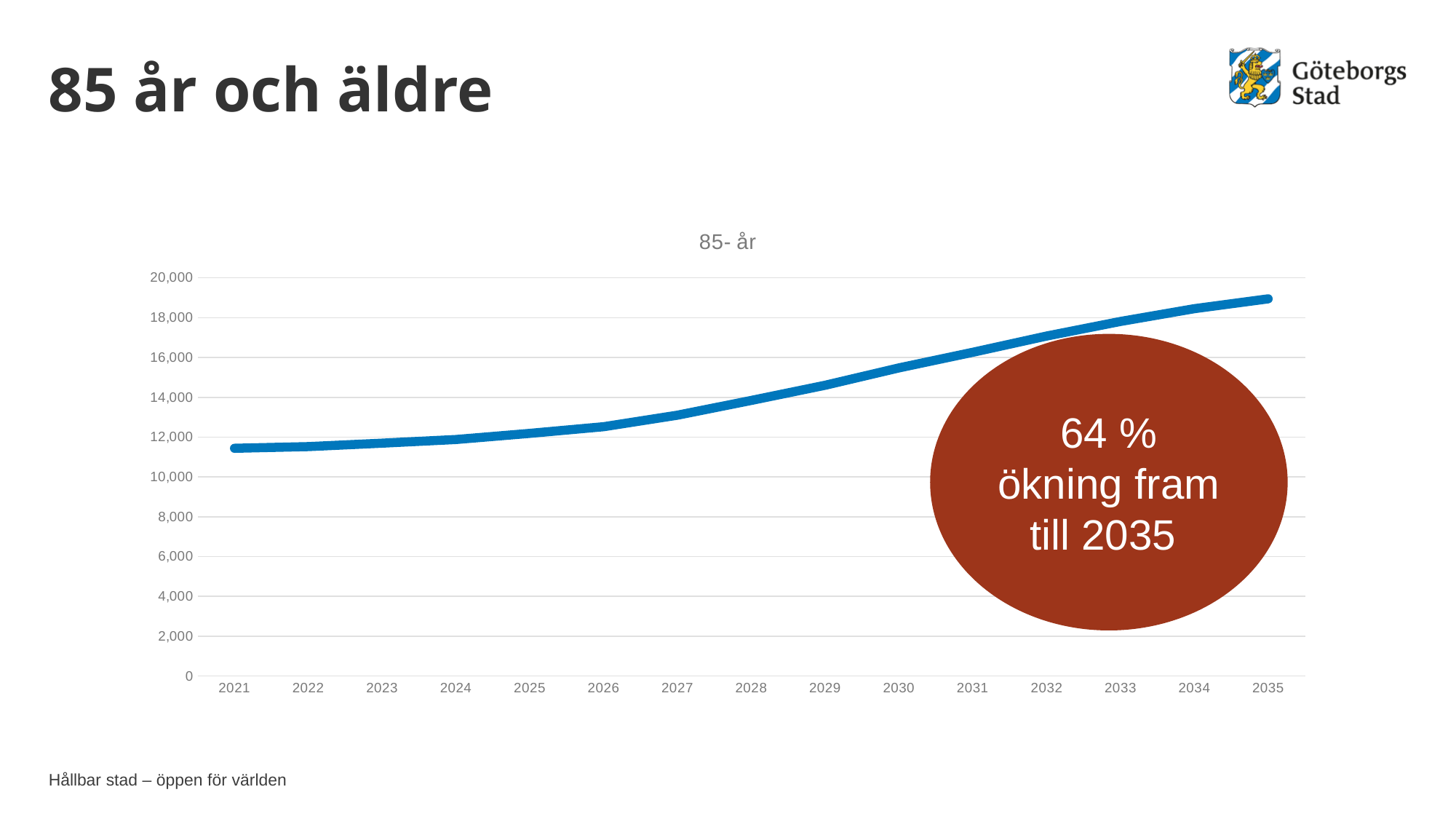
Which year has the highest value in the chart? 2035 Is the value for 2021 greater or less than 10,000? greater What kind of chart is shown on the slide? line chart What percentage increase up to 2035 does the red circle on the chart state? 64 % Is the value for 2021 greater or less than 12,000? less How many years are plotted along the x axis of the chart? 15 Is the value for 2035 greater or less than 18,000? greater What is the title of the chart? 85- år Which year has the lowest value in the chart? 2021 Do the values in the chart rise or fall from 2021 to 2035? rise Which year has the larger value, 2025 or 2030? 2030